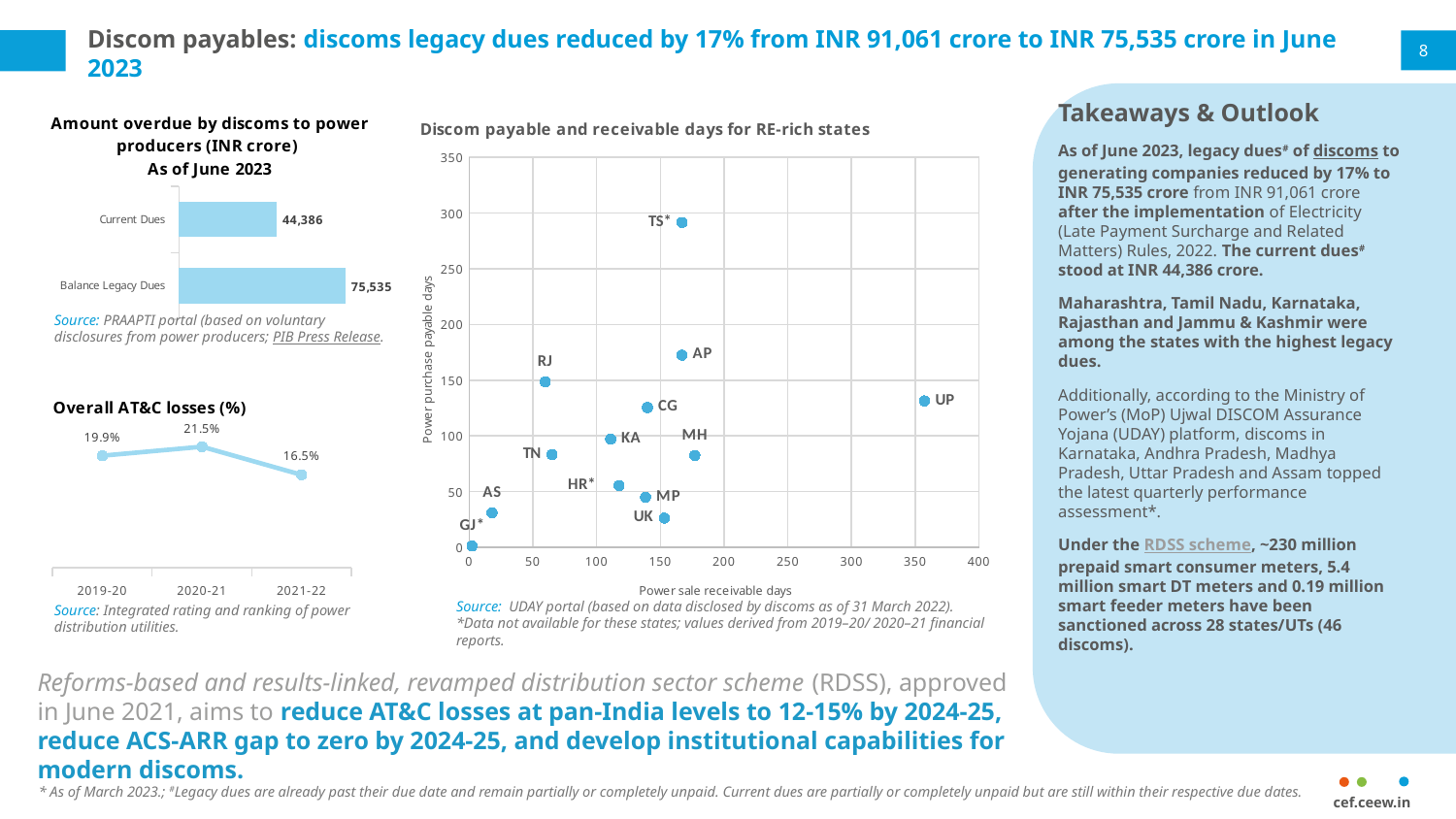
In the 'Overall AT&C losses (%)' chart, which year has the lowest value? 2021-22 In the 'Amount overdue by discoms to power producers' chart, what is the difference between Balance Legacy Dues and Current Dues? 31,149 In the 'Discom payable and receivable days for RE-rich states' chart, which state has the highest power purchase payable days? TS* In the 'Discom payable and receivable days for RE-rich states' chart, which state has the highest power sale receivable days? UP In the 'Overall AT&C losses (%)' chart, how many years are plotted? 3 What kind of chart is 'Amount overdue by discoms to power producers'? Bar chart In the 'Overall AT&C losses (%)' chart, what is the value for 2020-21? 21.5% In the 'Overall AT&C losses (%)' chart, what is the difference between the 2020-21 and 2021-22 values? 5.0% In the 'Amount overdue by discoms to power producers' chart, what is the value for Current Dues? 44,386 In the 'Amount overdue by discoms to power producers' chart, which category has the larger value? Balance Legacy Dues In the 'Discom payable and receivable days for RE-rich states' chart, is the power purchase payable days value for UP greater or less than 100? greater In the 'Amount overdue by discoms to power producers' chart, what is the value for Balance Legacy Dues? 75,535